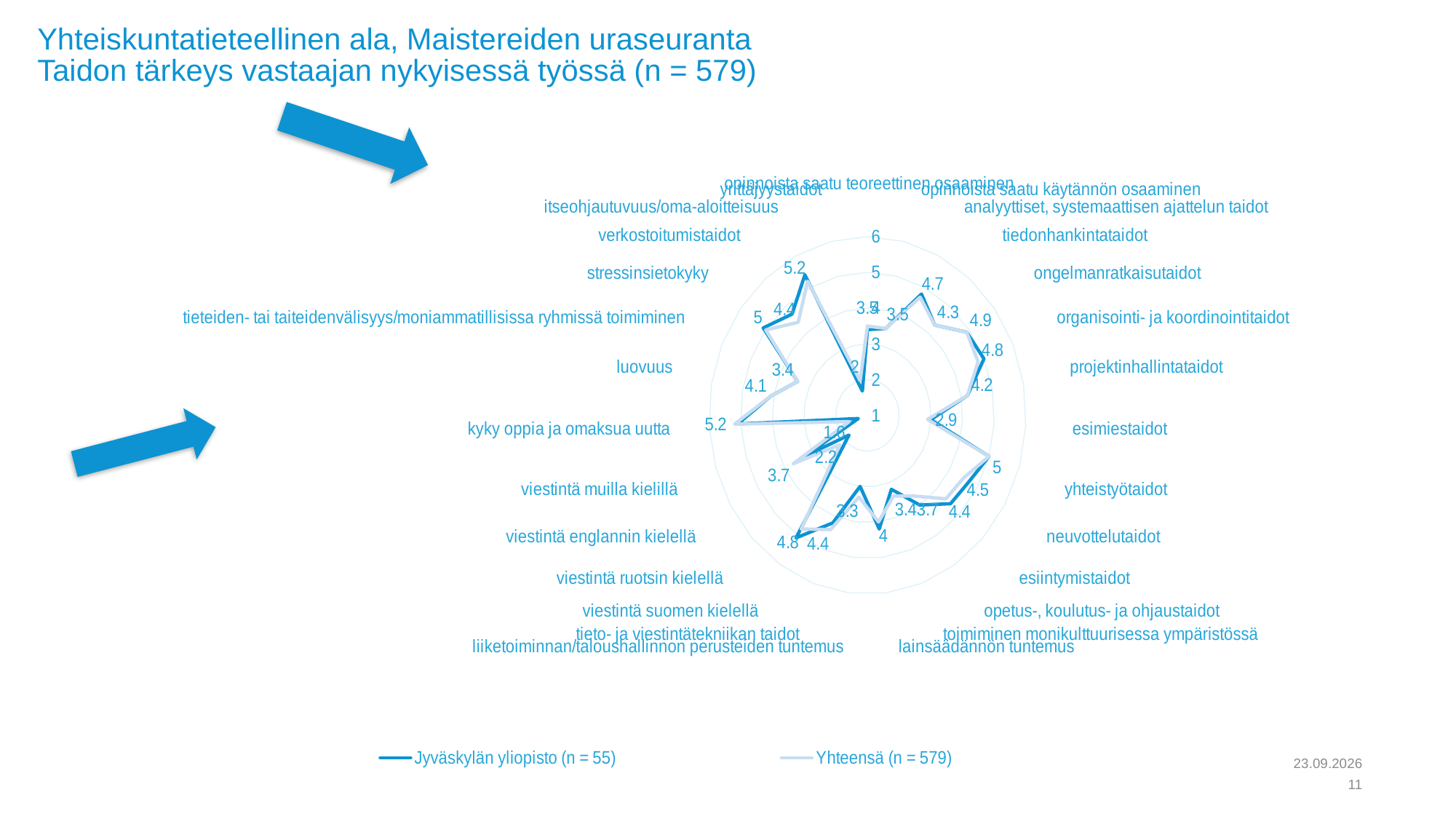
Which has a higher labelled value, ongelmanratkaisutaidot or tiedonhankintataidot? ongelmanratkaisutaidot How many skill categories are plotted around the radar chart? 27 What are the two series named in the legend? Jyväskylän yliopisto (n = 55) and Yhteensä (n = 579) Is the labelled value for stressinsietokyky greater or less than 4? greater What is the labelled value for kyky oppia ja omaksua uutta? 5.2 How many series does the legend list? 2 What kind of chart is shown on the slide? Radar chart What is the labelled value for yrittäjyystaidot? 2 What is the difference between the labelled values for yhteistyötaidot and esimiestaidot? 2.1 What is the labelled value for ongelmanratkaisutaidot? 4.9 What is the labelled value for esimiestaidot? 2.9 Which category has the lowest labelled value? viestintä muilla kielillä